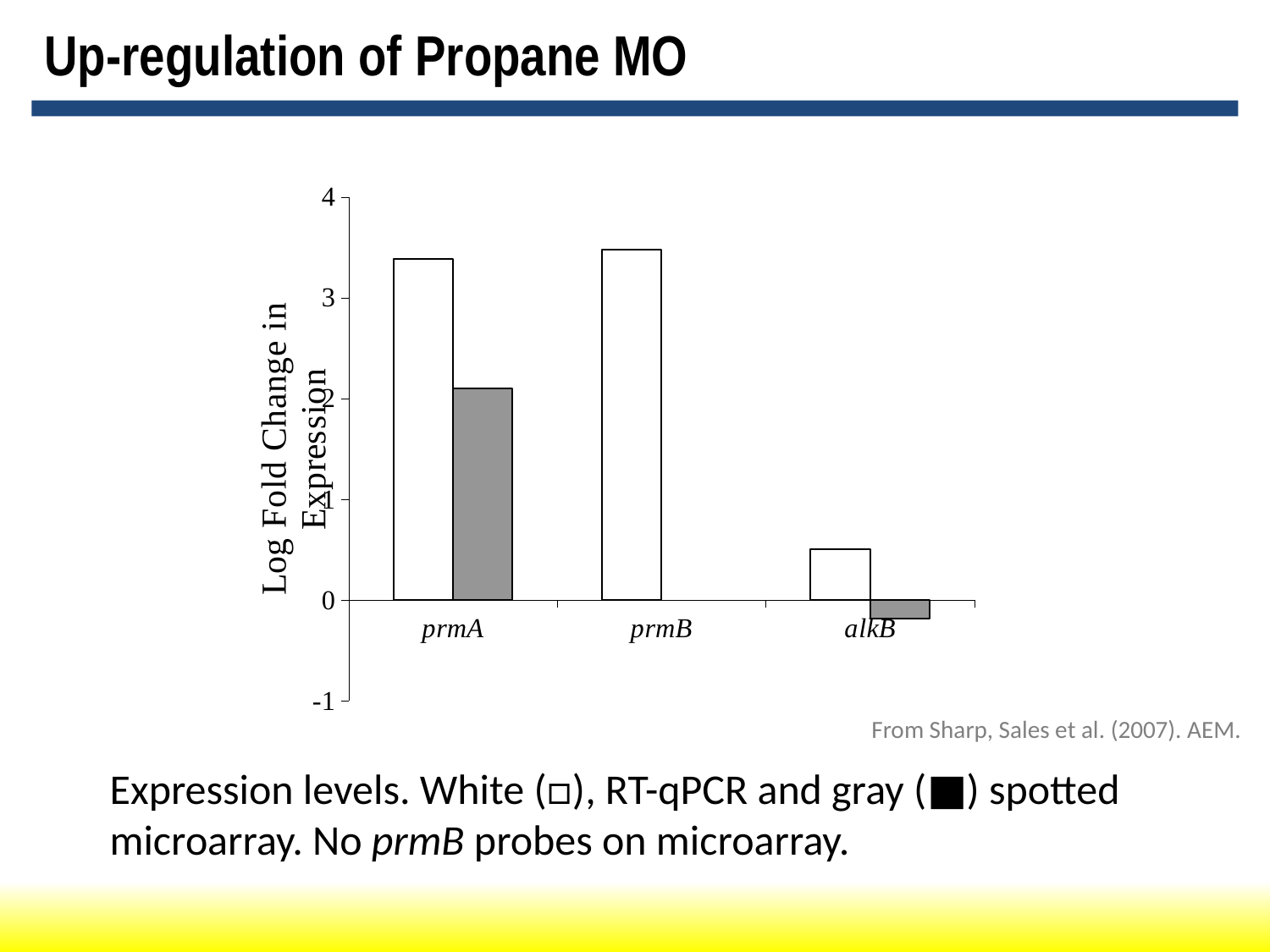
Is the white (RT-qPCR) value for prmB greater or less than 3? greater Is the white (RT-qPCR) value for prmA greater or less than 3? greater Is the gray (microarray) value for prmA greater or less than 2? greater How many gene categories are shown on the x axis? 3 What is the label of the y axis? Log Fold Change in Expression Do the gray (microarray) bars rise or fall from prmA to alkB? fall Which category has the lowest white (RT-qPCR) bar? alkB Which category has no gray (microarray) bar? prmB For prmA, which is larger: the white (RT-qPCR) bar or the gray (microarray) bar? white (RT-qPCR) What kind of chart is shown on the slide? bar chart